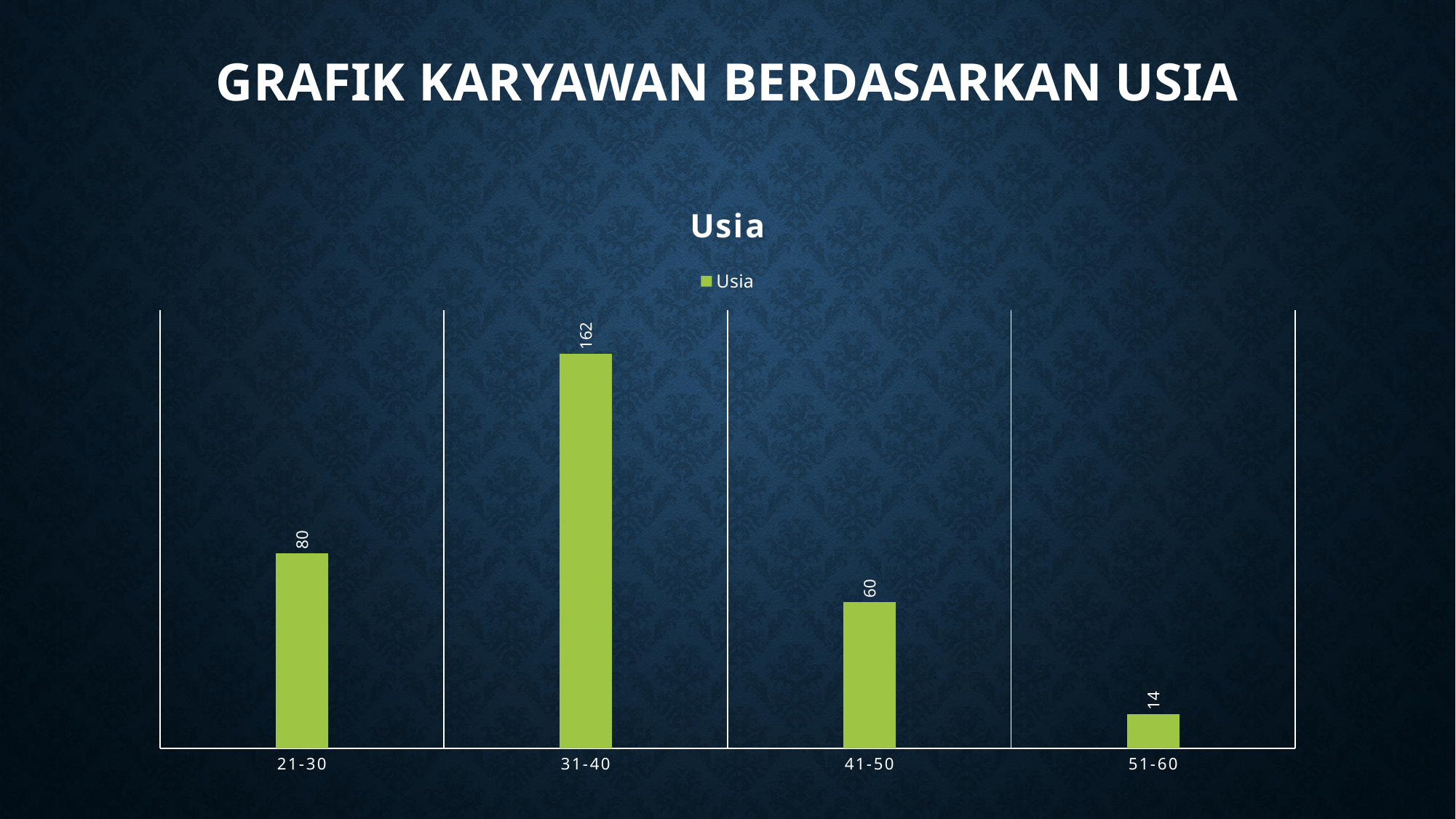
How many series does the legend list? 1 What is the value for the 51-60 age group? 14 What is the difference between the values for 31-40 and 21-30? 82 What is the value for the 41-50 age group? 60 Which age group has the highest value? 31-40 What is the value for the 31-40 age group? 162 What is the value for the 21-30 age group? 80 How many age groups are shown on the x axis? 4 Which age group has the lowest value? 51-60 What is the difference between the values for 41-50 and 51-60? 46 What kind of chart is shown on the slide? Bar chart Which is larger, the value for 21-30 or the value for 41-50? 21-30